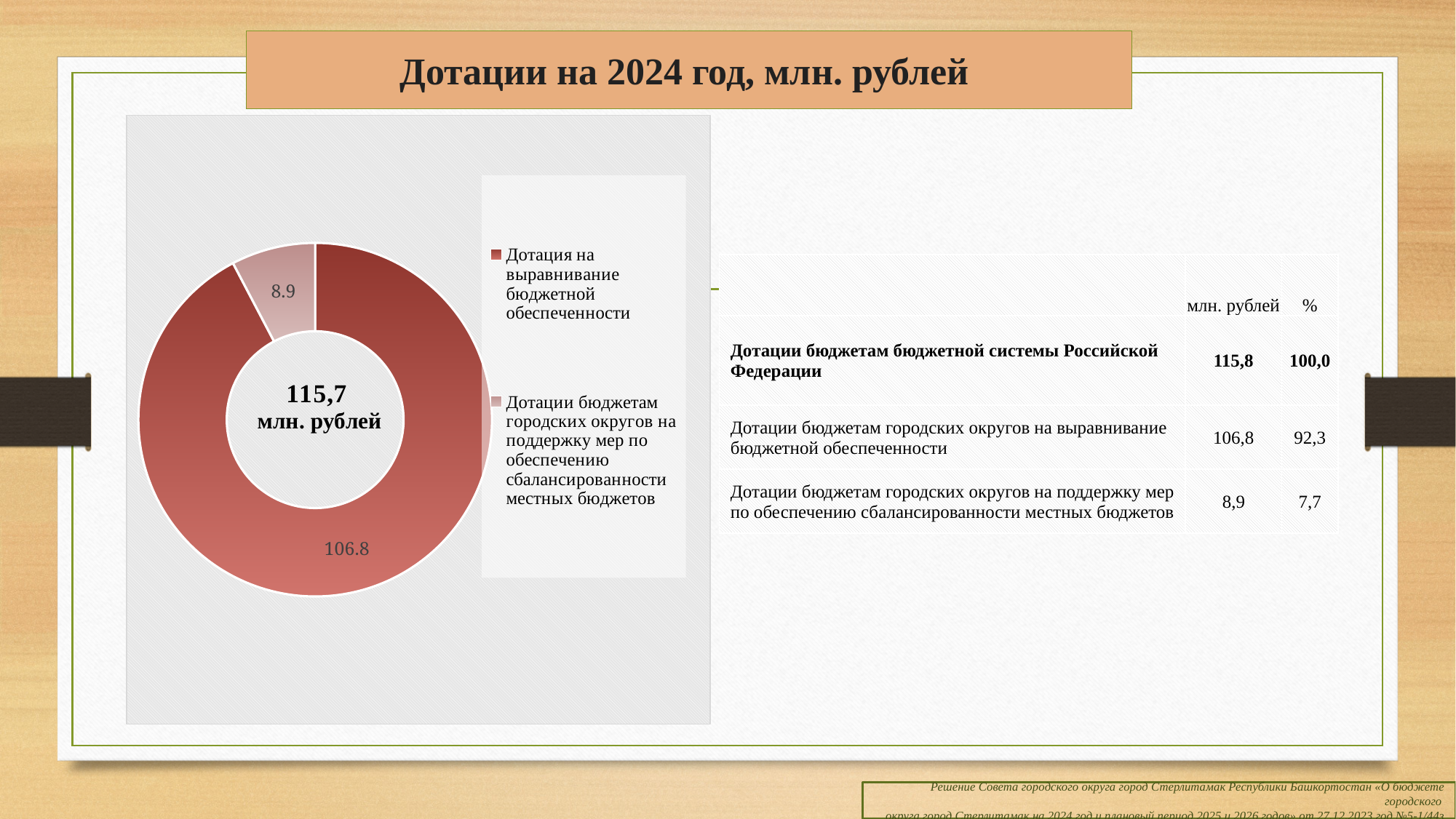
What value is shown for the slice "Дотации бюджетам городских округов на поддержку мер по обеспечению сбалансированности местных бюджетов"? 8.9 What is the difference between the two slice values in the chart (106.8 and 8.9)? 97.9 How many slices does the doughnut chart have? 2 What type of chart is shown on the slide? Doughnut (pie) chart Which category has the smallest slice in the chart? Дотации бюджетам городских округов на поддержку мер по обеспечению сбалансированности местных бюджетов According to the table next to the chart, what share (%) does the slice "на поддержку мер по обеспечению сбалансированности местных бюджетов" (8,9) have of the total? 7,7 How many entries does the chart legend list? 2 What total value is printed in the centre of the doughnut chart? 115,7 млн. рублей Which is larger: the slice for "Дотация на выравнивание бюджетной обеспеченности" or the slice for "поддержку мер по обеспечению сбалансированности местных бюджетов"? Дотация на выравнивание бюджетной обеспеченности What is the title of the slide containing the chart? Дотации на 2024 год, млн. рублей Which category has the largest slice in the chart? Дотация на выравнивание бюджетной обеспеченности What value is shown for the slice "Дотация на выравнивание бюджетной обеспеченности"? 106.8